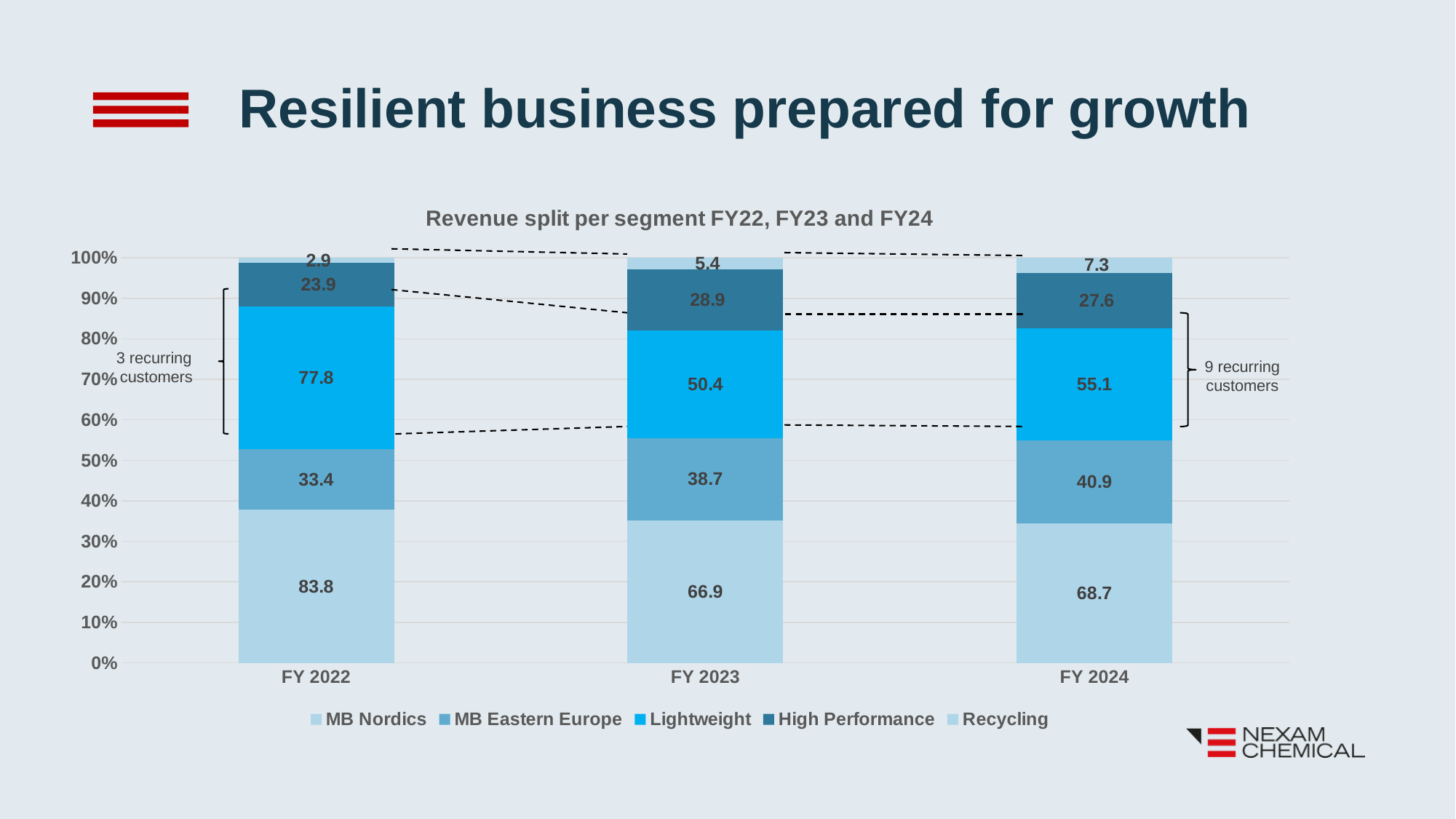
What kind of chart is shown on the slide? Stacked bar chart How many years are shown on the x axis? 3 Which year has the highest value for Lightweight? FY 2022 How many series does the legend list? 5 What is the value for MB Nordics in FY 2023? 66.9 What is the difference between the MB Eastern Europe values for FY 2024 and FY 2022? 7.5 What is the total of all segments in the FY 2023 bar? 190.3 What is the value for Lightweight in FY 2022? 77.8 What is the value for Recycling in FY 2024? 7.3 What is the value for High Performance in FY 2023? 28.9 Which is larger, the MB Nordics value in FY 2022 or in FY 2024? FY 2022 Which year has the lowest value for Recycling? FY 2022